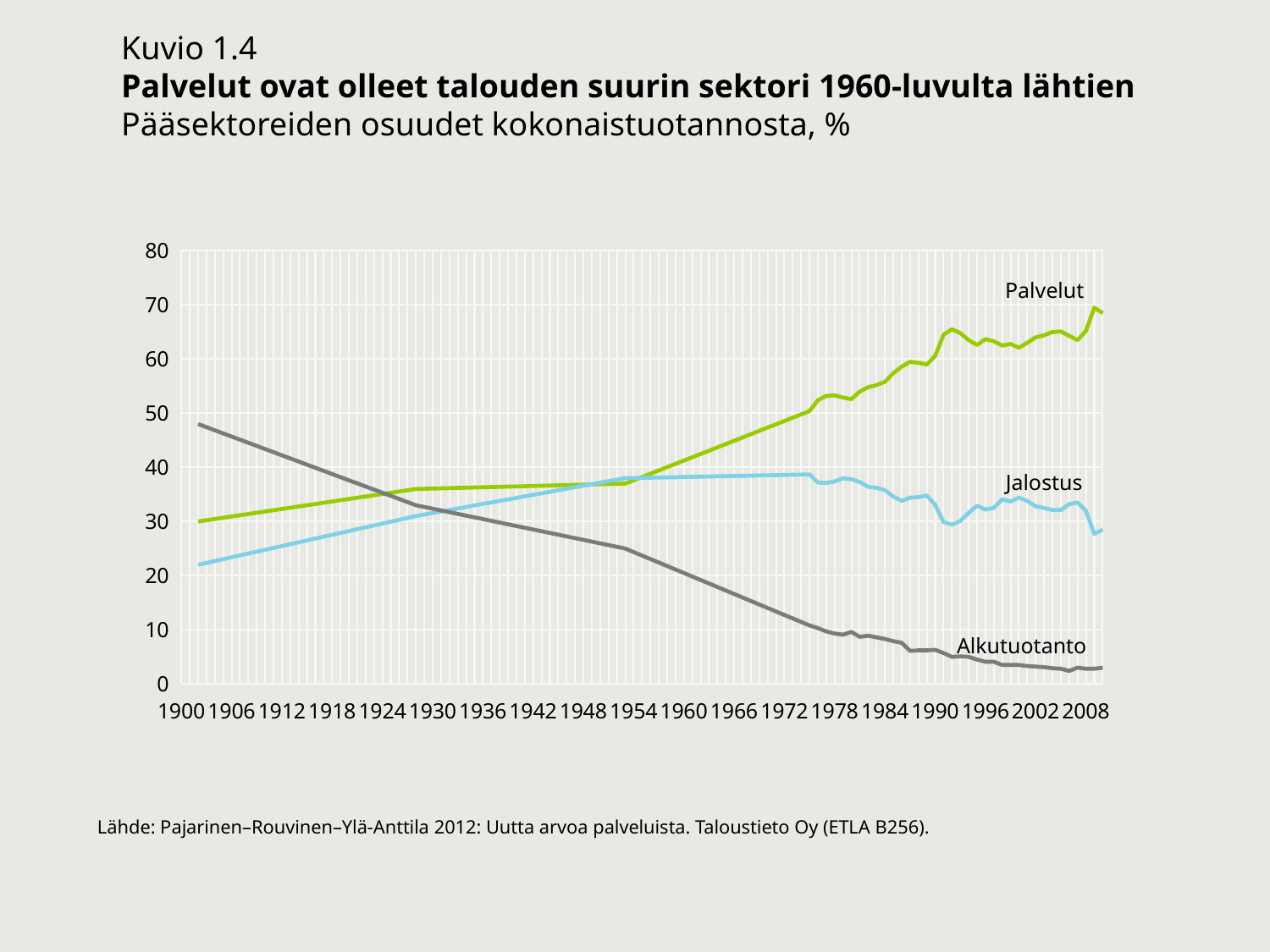
What kind of chart is shown on the slide? line chart Is the value for Palvelut in 2008 greater or less than 60? greater Does the Palvelut line rise or fall from 1900 to 2008? rise Which series has the highest value in 1900? Alkutuotanto Is the value for Jalostus in 1900 greater or less than 30? less Which series has the lowest value in 2008? Alkutuotanto Does the Alkutuotanto line rise or fall from 1900 to 2008? fall How many series are plotted in the chart? 3 Is the value for Alkutuotanto in 1900 greater or less than 40? greater In 2008, which is larger: Palvelut or Jalostus? Palvelut What is the highest value shown on the vertical axis? 80